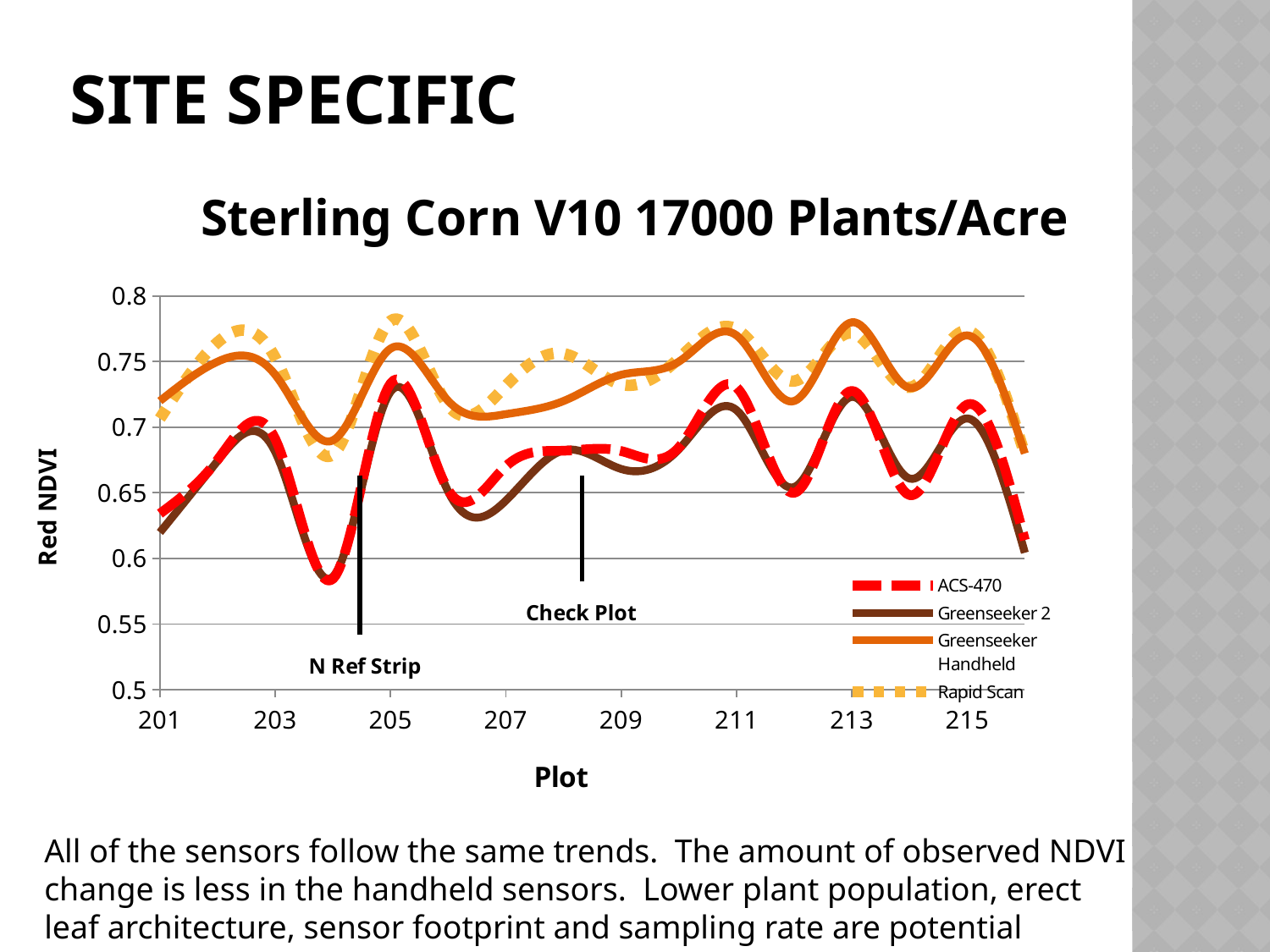
What are the two annotated regions labelled on the chart? N Ref Strip and Check Plot At plot 204, which series has the higher value: Greenseeker Handheld or Greenseeker 2? Greenseeker Handheld Is the Greenseeker Handheld value at plot 201 greater or less than 0.7? greater Is the Greenseeker Handheld value at plot 205 greater or less than 0.75? greater What is the title of the chart? Sterling Corn V10 17000 Plants/Acre How many plot numbers are labelled on the x axis? 8 How many series does the legend list? 4 At plot 205, which series has the higher value: Rapid Scan or Greenseeker 2? Rapid Scan What kind of chart is shown on the slide? Line chart Is the Greenseeker 2 value at plot 204 greater or less than 0.6? less